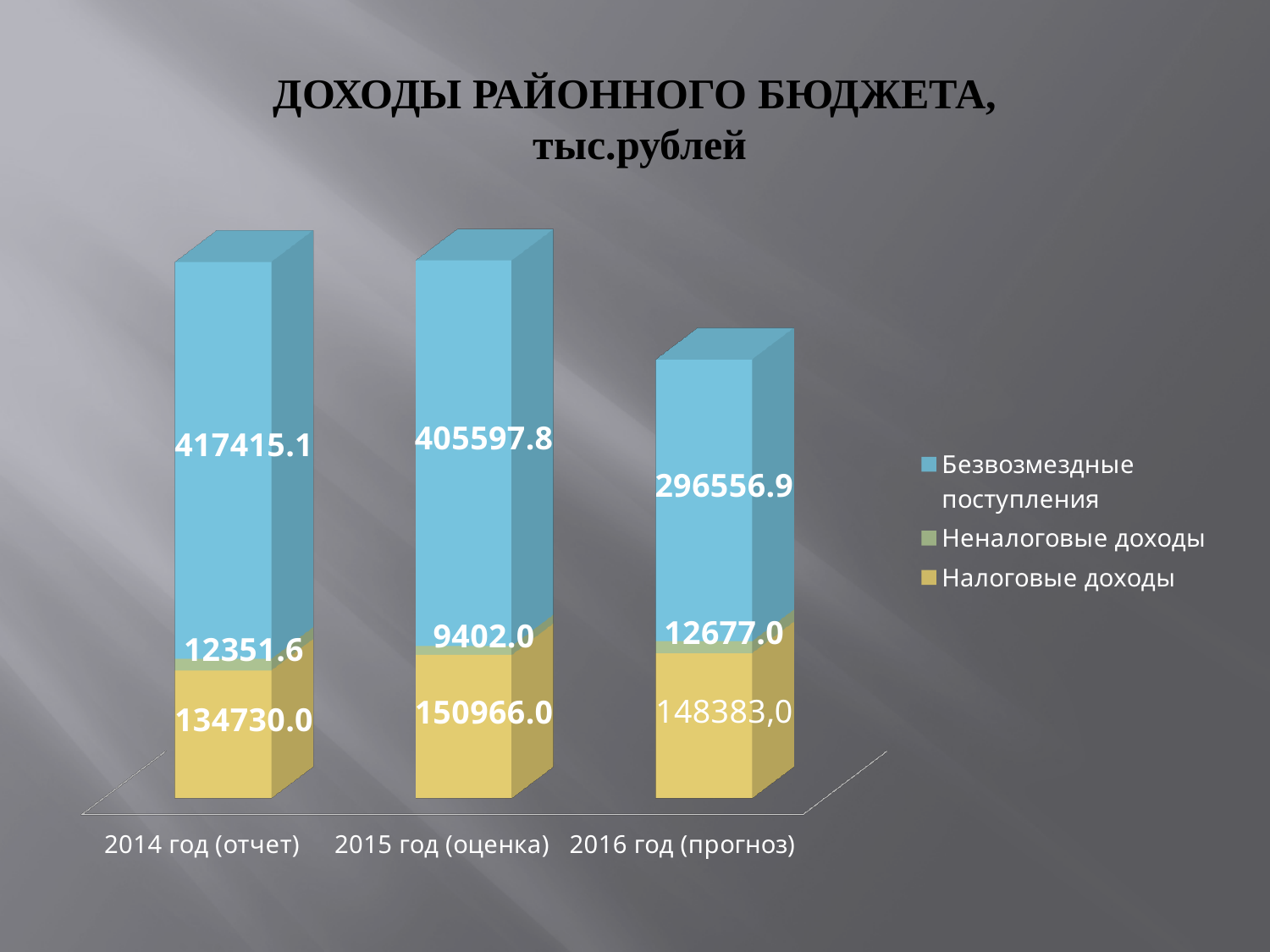
What is the value of Налоговые доходы for 2015 год (оценка)? 150966.0 In which year is Безвозмездные поступления the lowest? 2016 год (прогноз) How many categories (years) are shown on the x axis? 3 What is the value of Неналоговые доходы for 2016 год (прогноз)? 12677.0 In which year is Налоговые доходы the highest? 2015 год (оценка) What is the difference between Безвозмездные поступления in 2014 год (отчет) and 2016 год (прогноз)? 120858.2 What is the value of Безвозмездные поступления for 2014 год (отчет)? 417415.1 What is the value of Налоговые доходы for 2016 год (прогноз)? 148383,0 What kind of chart is shown on the slide? Stacked bar chart How many series does the legend list? 3 What is the total of the stacked bar for 2015 год (оценка)? 565965.8 Which is larger: Неналоговые доходы in 2014 год (отчет) or in 2015 год (оценка)? 2014 год (отчет)